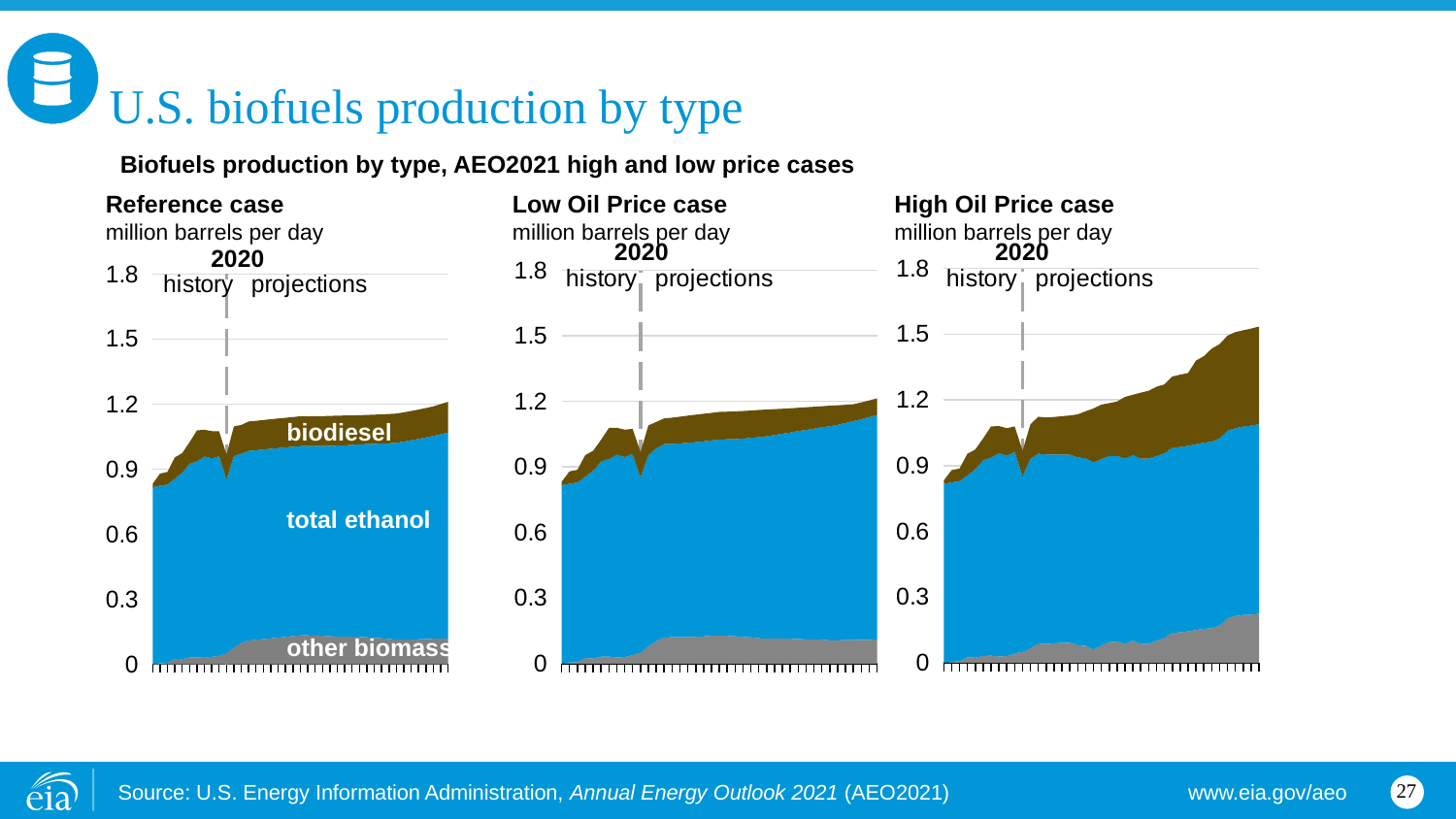
In the High Oil Price case chart, does total biofuels production rise or fall over the projection period? rise In the Low Oil Price case chart, is total biofuels production at the end of the projection period greater or less than 0.9 million barrels per day? greater In the Reference case chart, is total biofuels production at the end of the projection period greater or less than 1.5 million barrels per day? less What unit is used on the y axis of the three charts? million barrels per day In the High Oil Price case chart, is total biofuels production at the end of the projection period greater or less than 1.2 million barrels per day? greater How many charts (cases) are shown on the slide? 3 How many biofuel types (series) are stacked in the Reference case chart? 3 In the Reference case chart, which biofuel type is the largest component of production? total ethanol Which year marks the boundary between history and projections in the charts? 2020 In the Reference case chart, which biofuel type is the smallest component of production? other biomass What kind of chart is used for the Reference case panel? stacked area chart Which case shows higher total biofuels production at the end of the projection period, the High Oil Price case or the Low Oil Price case? High Oil Price case